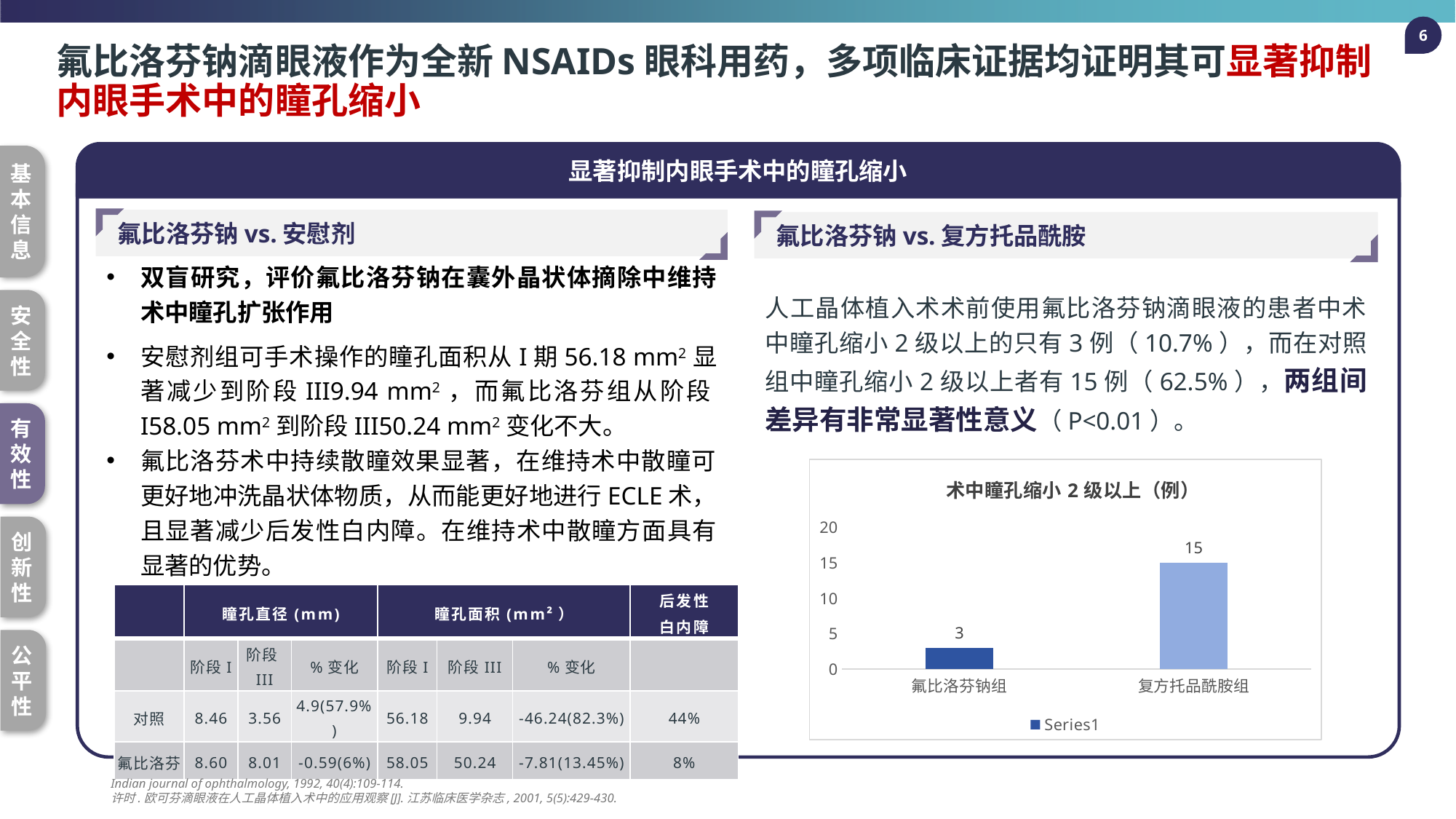
What kind of chart is shown on the slide? bar chart Which is larger, the value for 氟比洛芬钠组 or the value for 复方托品酰胺组? 复方托品酰胺组 How many categories are shown in the chart? 2 Is the value for 复方托品酰胺组 greater or less than 10? greater How many series does the chart legend list? 1 Which category has the highest value in the chart? 复方托品酰胺组 Which category has the lowest value in the chart? 氟比洛芬钠组 What is the difference between the values for 复方托品酰胺组 and 氟比洛芬钠组? 12 What is the value for 氟比洛芬钠组 in the chart? 3 What is the value for 复方托品酰胺组 in the chart? 15 What is the title of the chart? 术中瞳孔缩小 2 级以上（例） Is the value for 氟比洛芬钠组 greater or less than 5? less